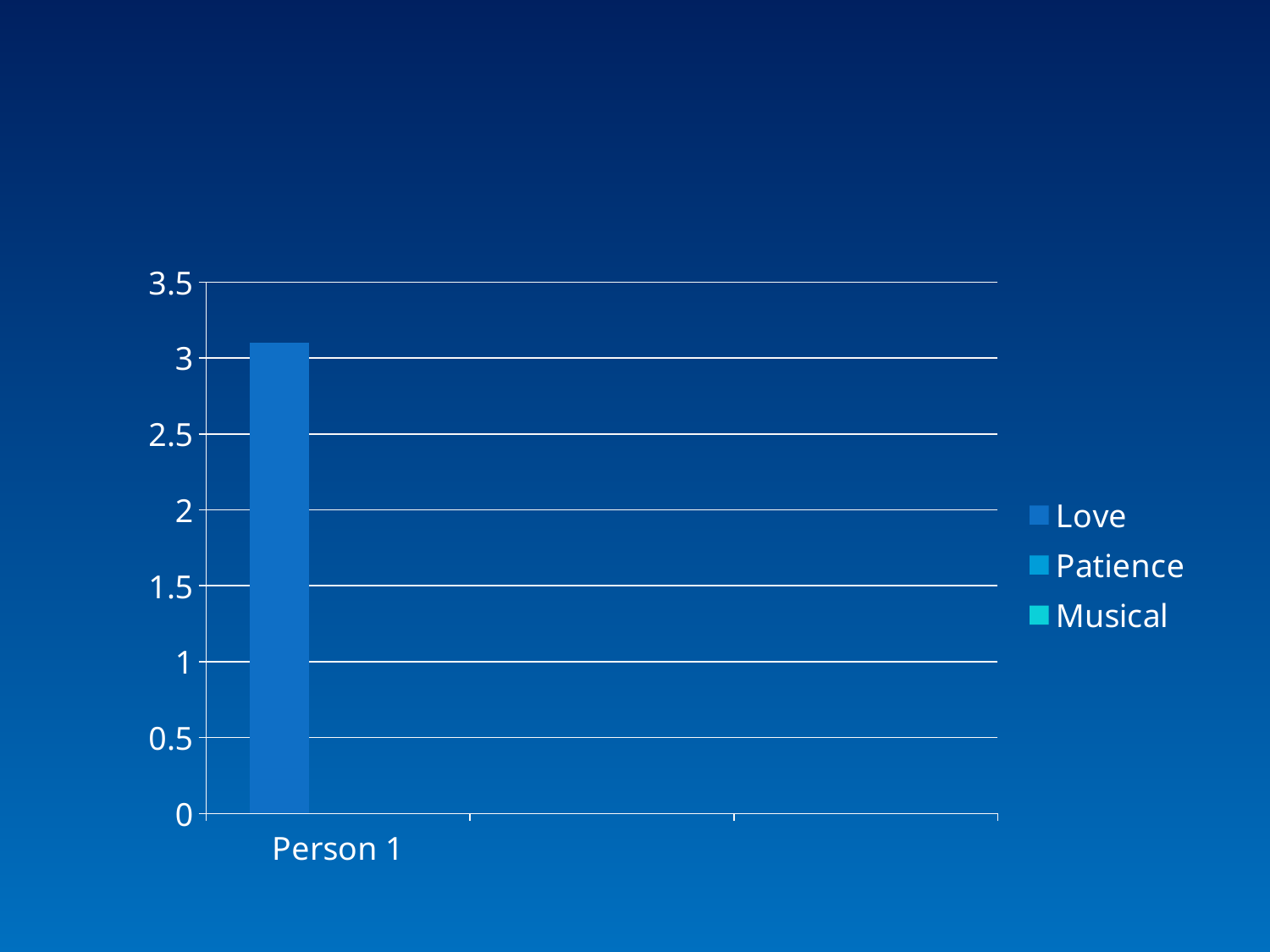
What is the highest value shown on the y axis? 3.5 Is the value of the Love bar for Person 1 greater or less than 3? greater What kind of chart is shown on the slide? bar chart What is the category label shown on the x axis? Person 1 Is the value of the Love bar for Person 1 greater or less than 3.5? less How many series does the legend list? 3 What are the three series named in the legend? Love, Patience, Musical Is the value of the Love bar for Person 1 greater or less than 2? greater Which series does the only plotted bar belong to? Love How many bars are plotted on the chart? 1